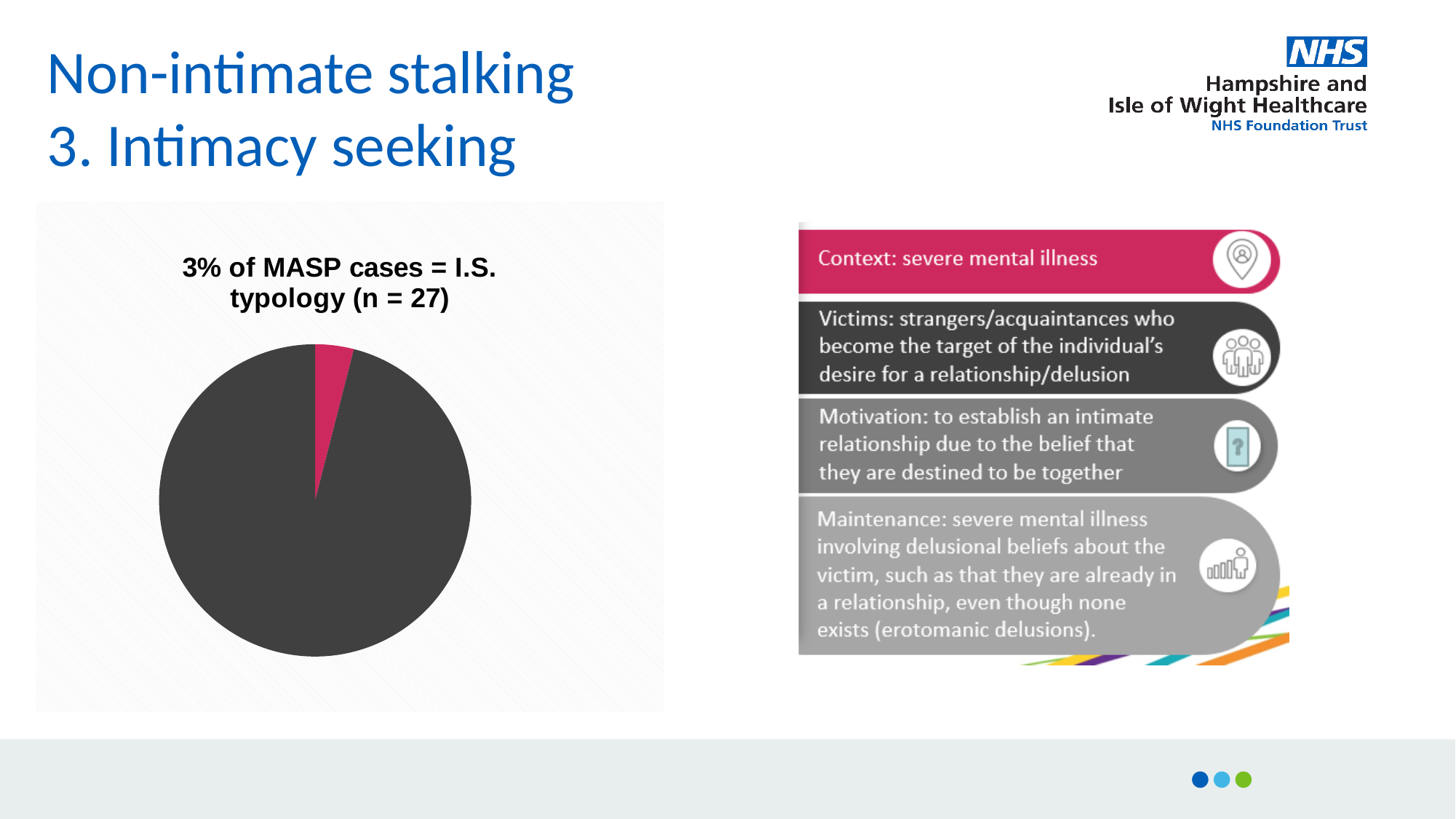
Is the share of the dark grey slice in the pie chart greater or less than 50%? greater According to the pie chart title, what percentage of MASP cases are the I.S. typology? 3% Which slice of the pie chart is larger, the dark grey slice or the pink slice? the dark grey slice What colour is the smallest slice of the pie chart? pink How many slices does the pie chart have? 2 What kind of chart is shown on the left of the slide? pie chart What is the title of the pie chart? 3% of MASP cases = I.S. typology (n = 27) Is the share of the pink slice in the pie chart greater or less than 50%? less What is the value of n given in the pie chart title? 27